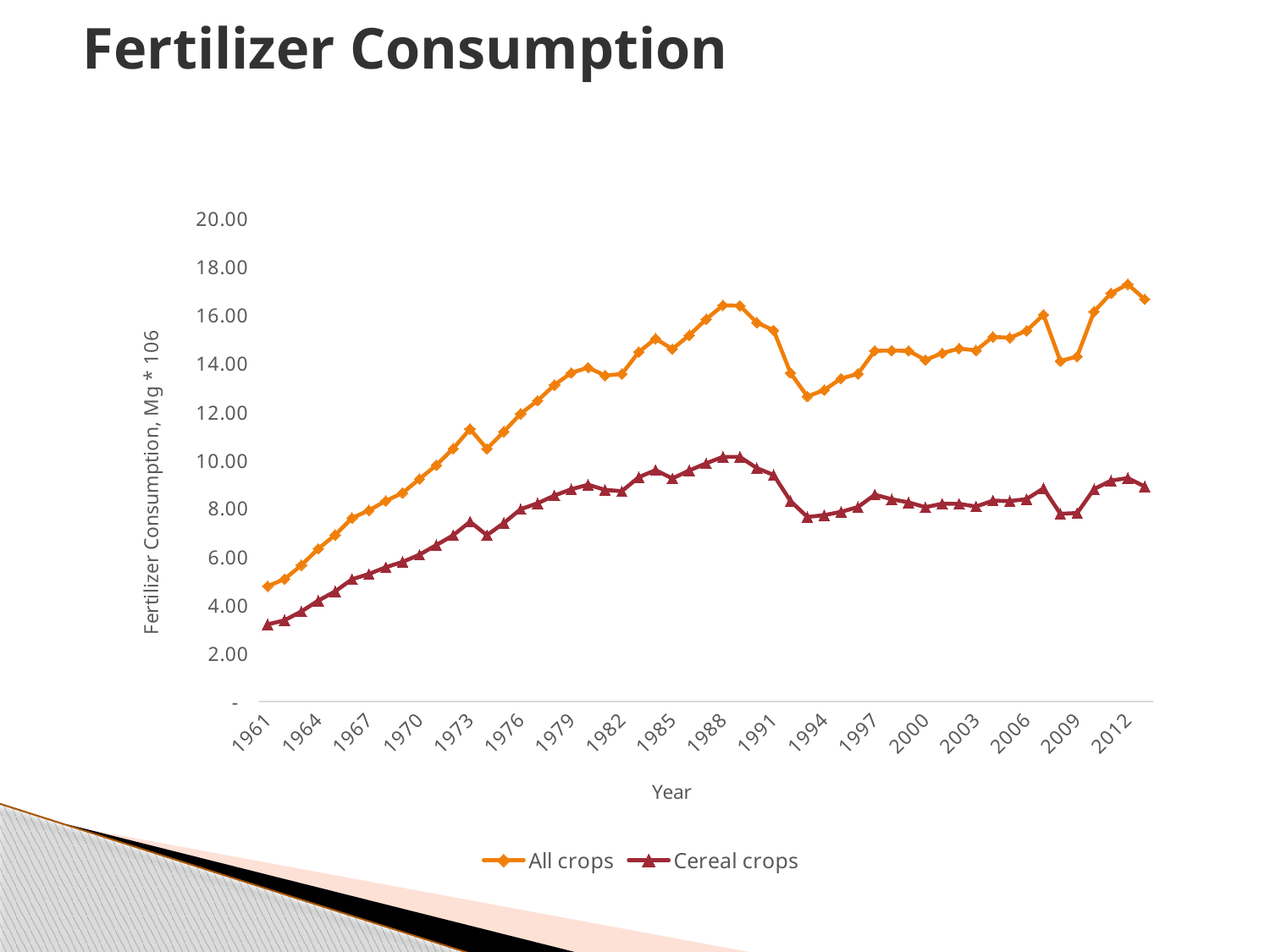
What is the label on the x axis? Year Is the value for All crops in 1988 greater or less than 14.00? greater Is the value for All crops in 1961 greater or less than 6.00? less Is the value for Cereal crops in 1988 greater or less than 8.00? greater Which series has the higher value in 1985, All crops or Cereal crops? All crops Do the values for Cereal crops rise or fall between 1988 and 1994? fall What kind of chart is shown on the slide? line chart Do the values for All crops rise or fall between 1961 and 1973? rise What is the title of the chart? Fertilizer Consumption How many series does the legend list? 2